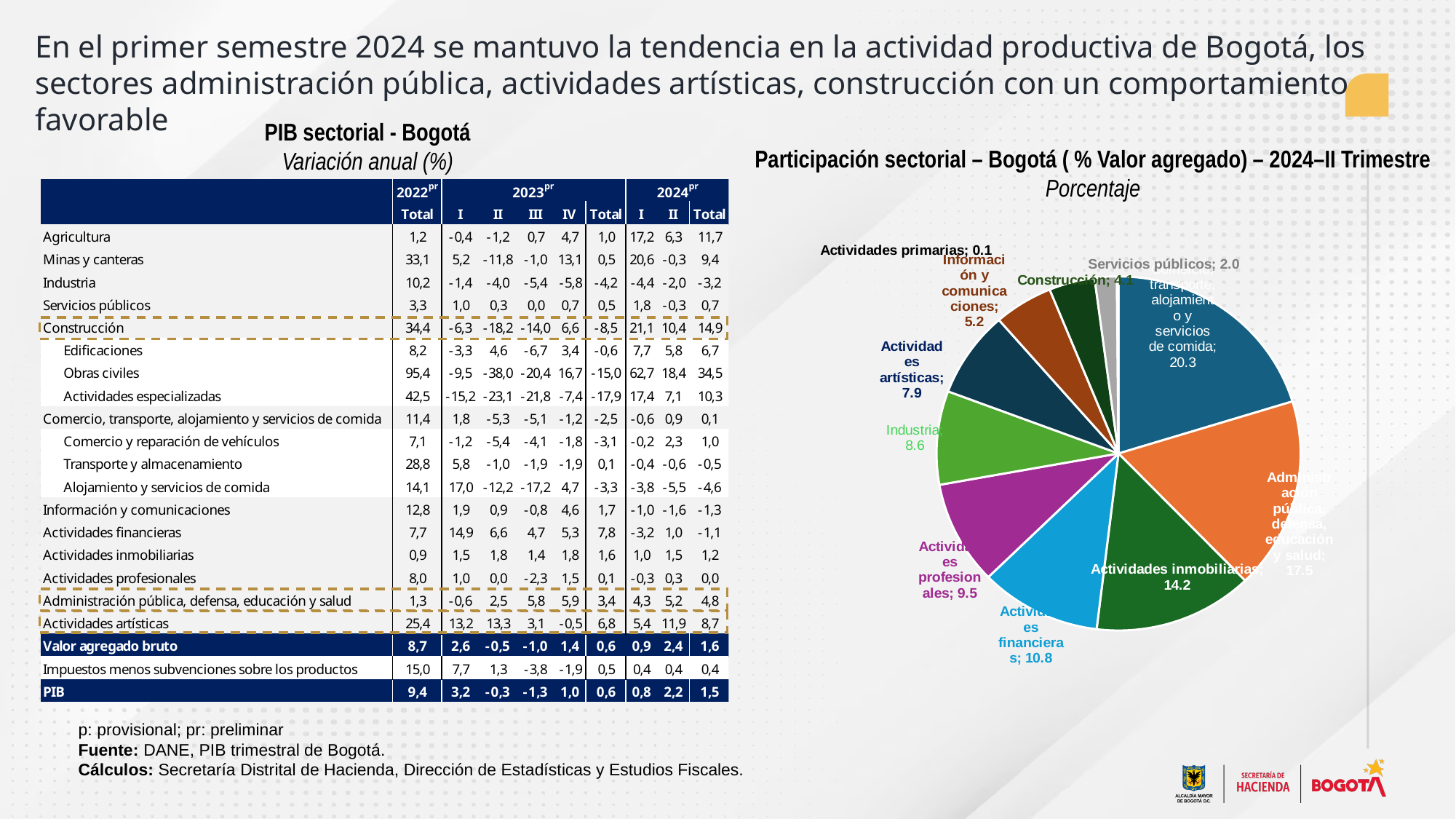
What kind of chart is shown on the right side of the slide? Pie chart In the pie chart, what is the share of Industria? 8.6 In the pie chart, what is the share of Servicios públicos? 2.0 In the pie chart, what is the share of Actividades financieras? 10.8 Which sector has the smallest slice in the pie chart? Actividades primarias In the pie chart, which is larger: Actividades profesionales or Actividades artísticas? Actividades profesionales Which sector has the largest slice in the pie chart? Comercio, transporte, alojamiento y servicios de comida In the pie chart, what is the share of Construcción? 4.1 In the pie chart, what is the difference between the shares of Administración pública, defensa, educación y salud and Actividades inmobiliarias? 3.3 How many sectors (slices) are shown in the pie chart? 11 What is the title of the pie chart? Participación sectorial – Bogotá (% Valor agregado) – 2024–II Trimestre In the pie chart, what is the share of Actividades inmobiliarias? 14.2